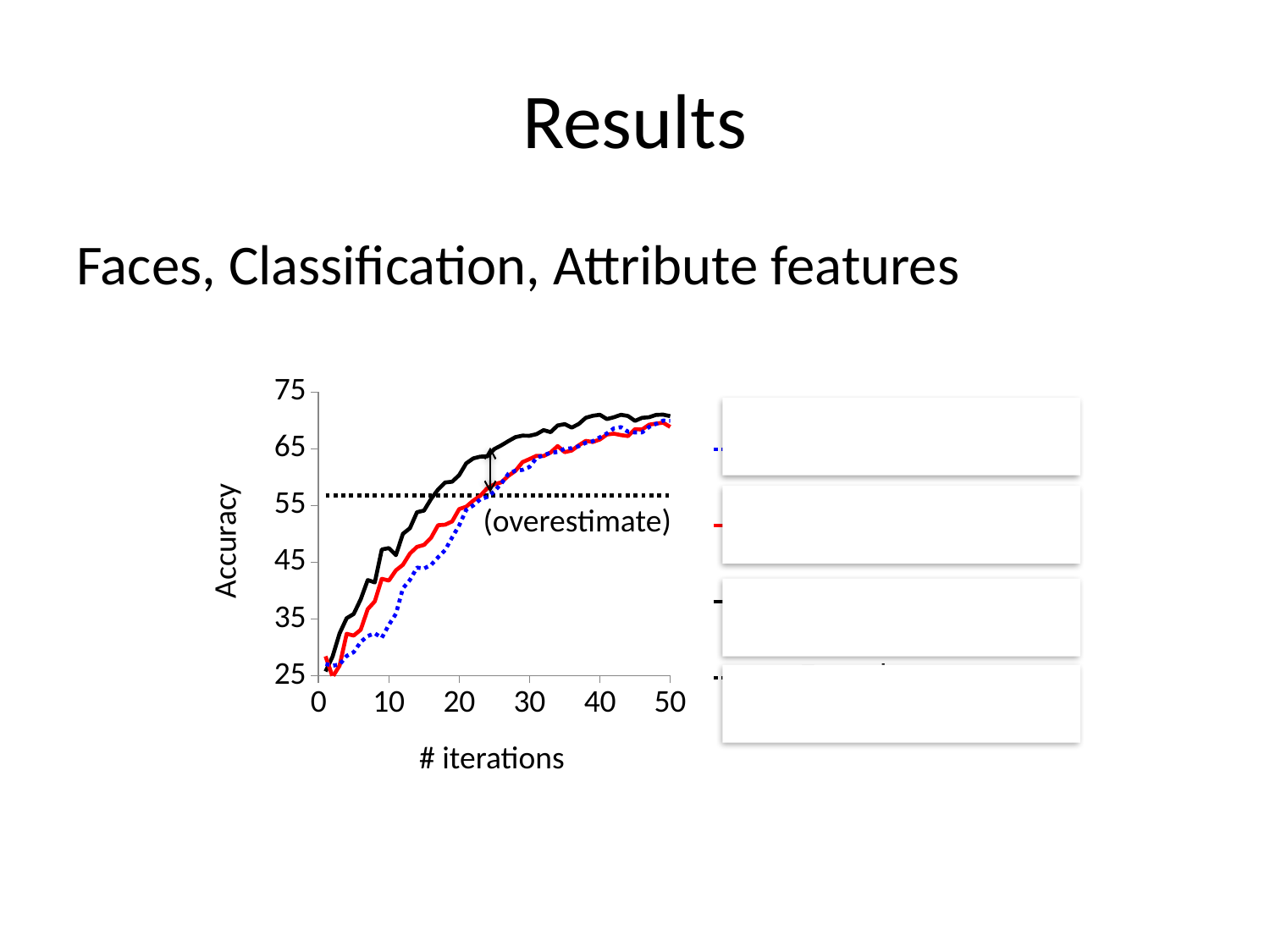
Which curve reaches the highest accuracy in the chart: the black solid line, the red solid line, or the blue dotted line? black solid line Is the accuracy of the black solid line at 50 iterations greater or less than 65? greater Is the horizontal dotted line in the chart above or below an accuracy of 55? above Is the accuracy of the red solid line at 10 iterations greater or less than 45? less What is the label of the x axis of the chart? # iterations What text annotation is written next to the horizontal dotted line in the chart? (overestimate) At 20 iterations, is the accuracy of the black solid line higher or lower than that of the blue dotted line? higher What kind of chart is shown on the slide? line chart At 10 iterations, which curve has the lowest accuracy: the black solid line, the red solid line, or the blue dotted line? blue dotted line Do the accuracy curves rise or fall as the number of iterations increases? rise